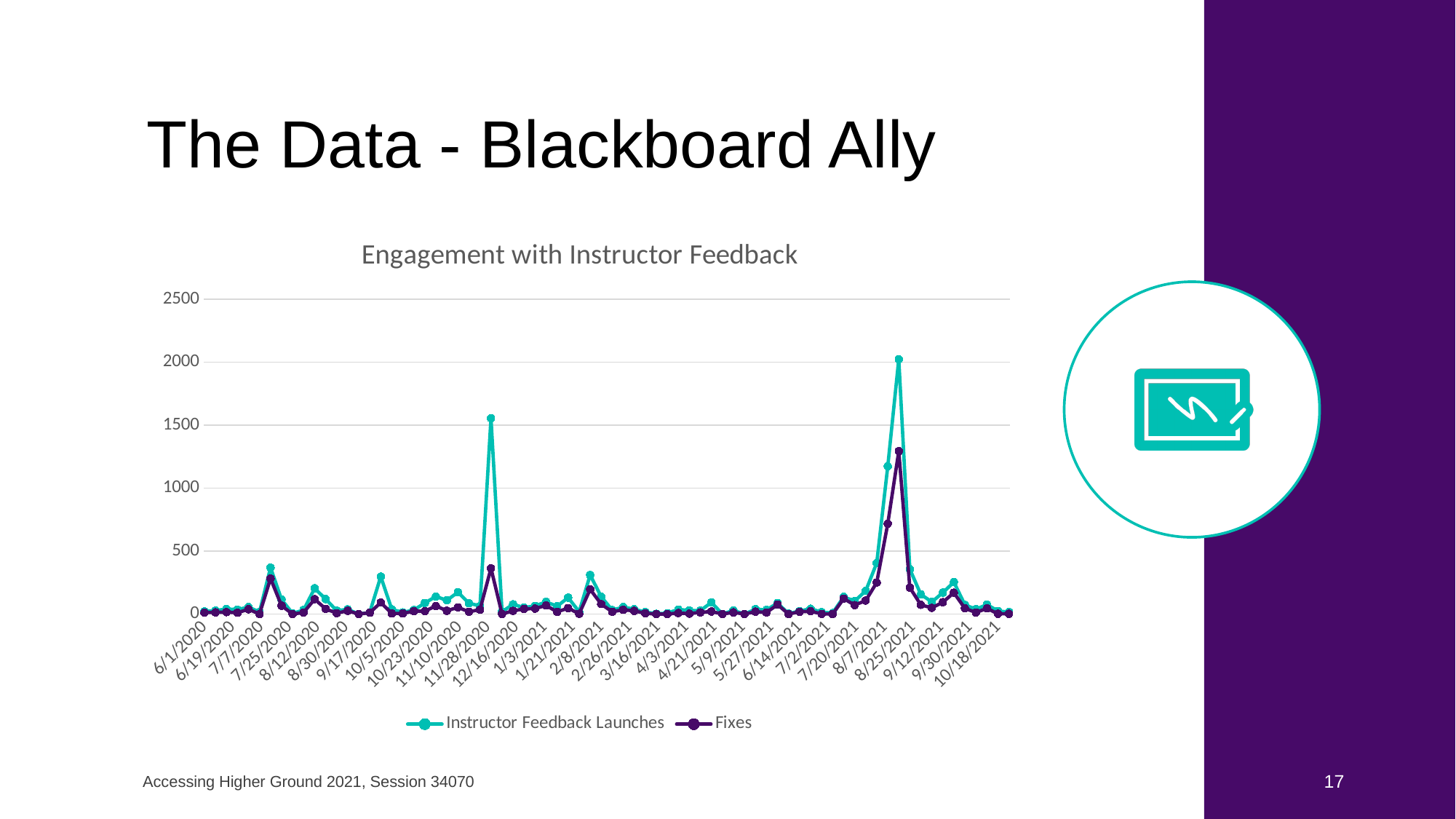
Is the value of Instructor Feedback Launches at 11/28/2020 greater or less than 1000? greater Is the highest value of Instructor Feedback Launches greater or less than 1500? greater Is the highest value of Fixes greater or less than 1000? greater What kind of chart is shown on the slide? line chart What is the highest value shown on the vertical axis of the chart? 2500 At the peak around 8/25/2021, which series has the larger value, Instructor Feedback Launches or Fixes? Instructor Feedback Launches At 11/28/2020, which series has the larger value, Instructor Feedback Launches or Fixes? Instructor Feedback Launches Which series is drawn in purple in the chart? Fixes How many series does the legend of the chart list? 2 What is the title of the chart? Engagement with Instructor Feedback